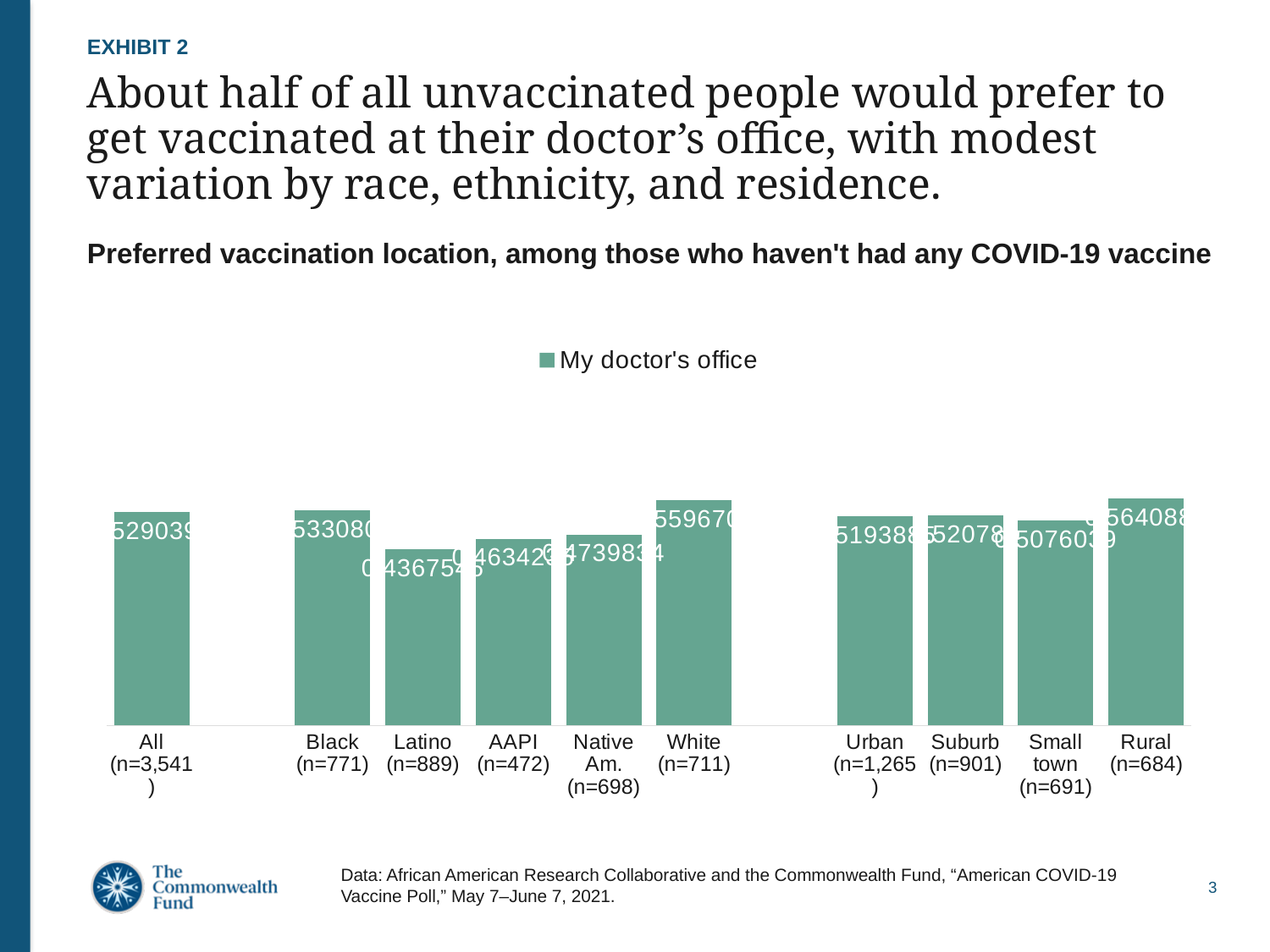
What sample size is shown for the Black category? n=771 Which category has the lowest bar? Latino What is the chart's subtitle describing the measure plotted? Preferred vaccination location, among those who haven't had any COVID-19 vaccine What sample size is shown for the Urban category? n=1,265 Which is larger, the value for Rural or the value for Urban? Rural What is the legend entry for the series shown? My doctor's office How many categories are plotted along the x axis? 10 What kind of chart is shown on the slide? bar chart Which is larger, the value for Black or the value for Latino? Black Which is larger, the value for White or the value for Native Am.? White How many series does the legend list? 1